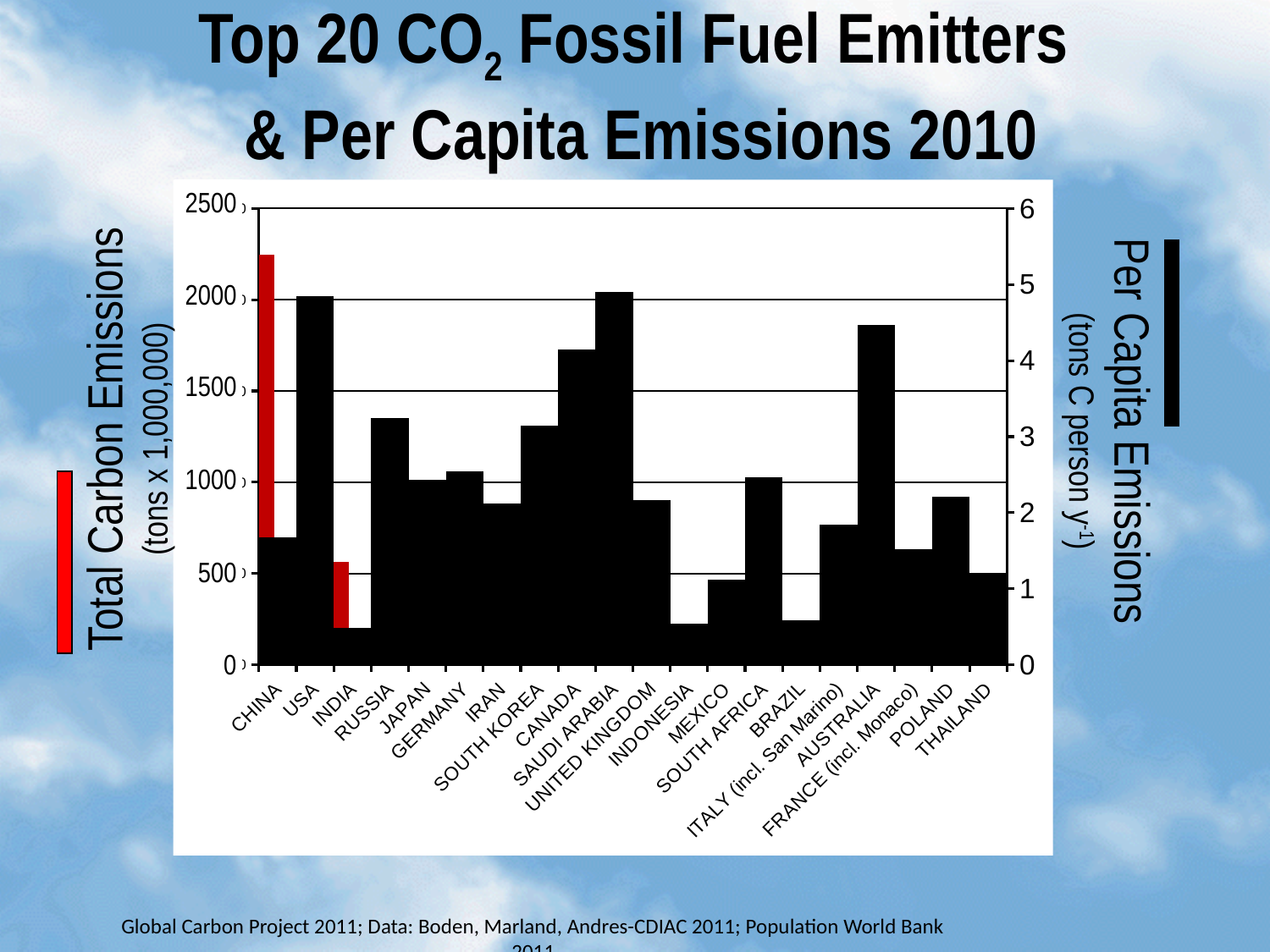
Is the Per Capita Emissions value for INDONESIA greater or less than 1? less How many countries are shown along the x axis of the chart? 20 Is the Total Carbon Emissions value for CHINA greater or less than 2000? greater What kind of chart is shown on the slide? bar chart What colour are the Total Carbon Emissions bars in the chart? red How many series does the chart's legend list? 2 Which has the higher Per Capita Emissions value, CANADA or JAPAN? CANADA Is the Per Capita Emissions value for USA greater or less than 4? greater Which has the higher Total Carbon Emissions value, CHINA or INDIA? CHINA Which has the higher Per Capita Emissions value, RUSSIA or MEXICO? RUSSIA